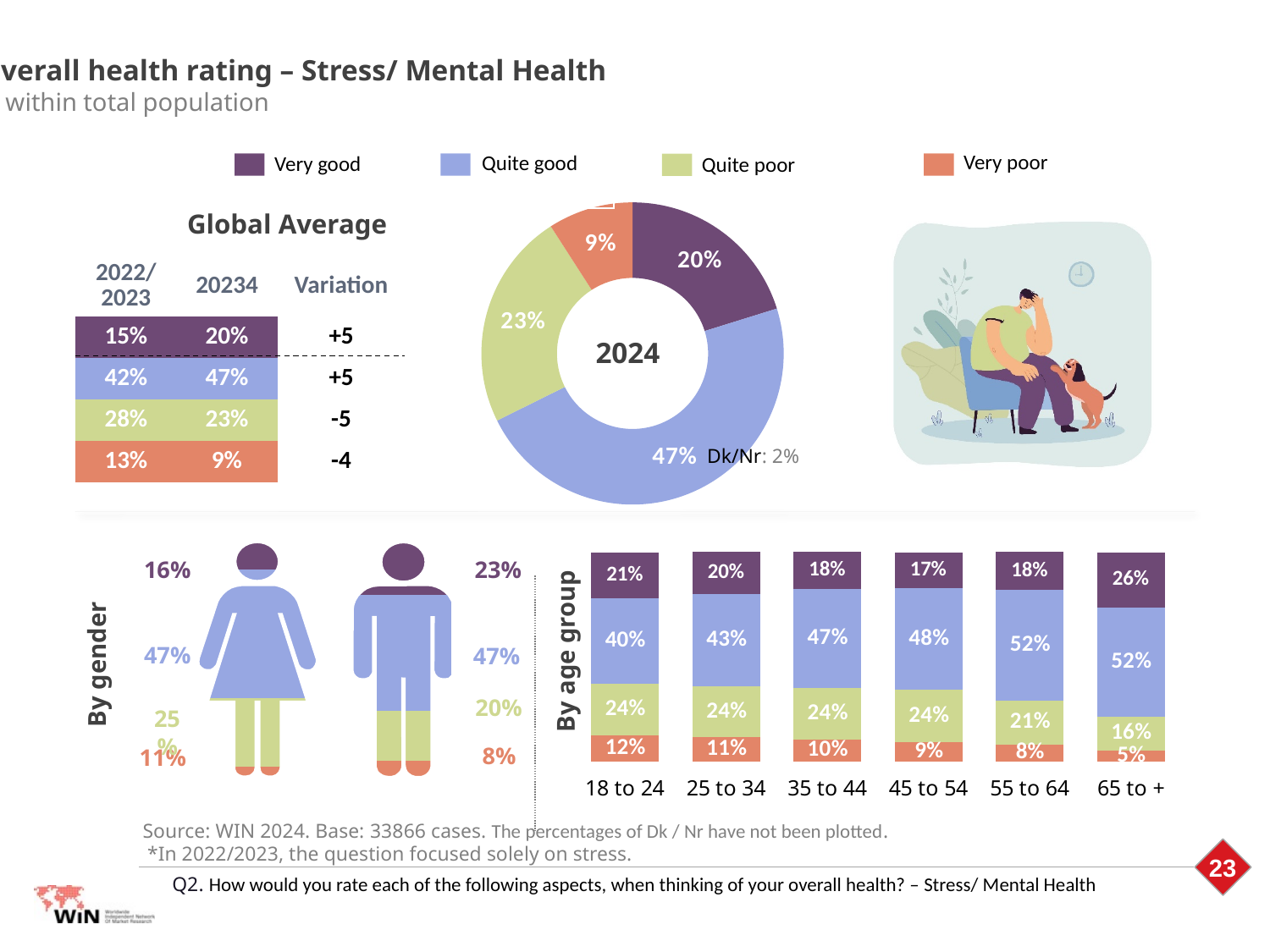
In the 2024 donut chart, which rating has the largest slice? Quite good In the By age group chart, which age group has the highest Very poor value? 18 to 24 In the By age group chart, which has the larger Very good value: 65 to + or 45 to 54? 65 to + In the By age group chart, what is the Very good value for the 65 to + group? 26% In the 2024 donut chart, what percentage is shown for Quite good? 47% How many age groups are shown in the By age group chart? 6 How many rating categories does the legend at the top of the slide list? 4 In the By age group chart, what is the difference between the Quite good value for 65 to + and for 18 to 24? 12 percentage points In the By age group chart, does the Very poor value rise or fall as the age groups get older? Fall What kind of chart is the By age group chart? Stacked bar chart In the By age group chart, what is the Quite good value for the 35 to 44 group? 47% In the 2024 donut chart, which rating has the smallest slice? Very poor